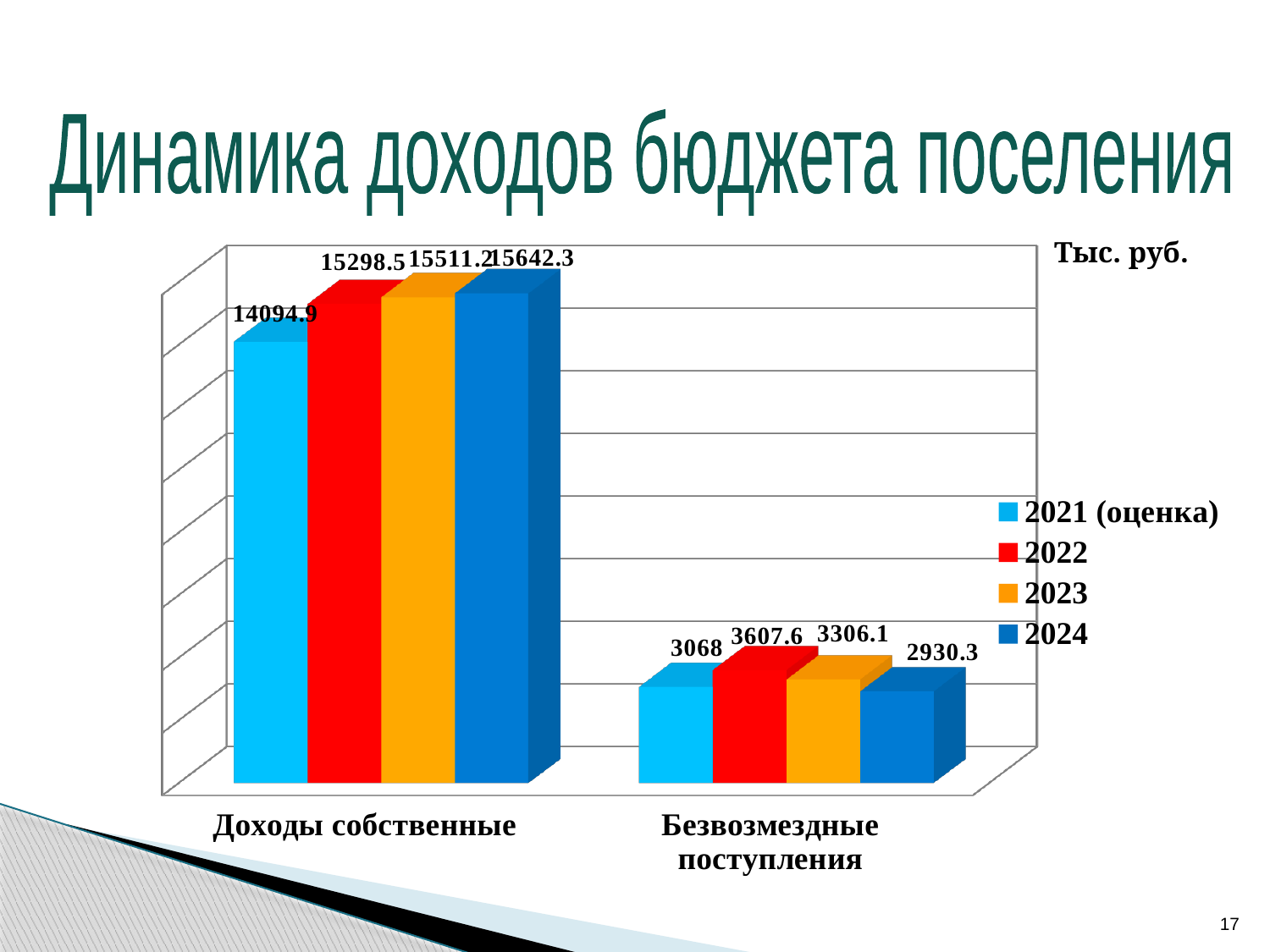
What is the value for 2023 in the "Безвозмездные поступления" category? 3306.1 What is the difference between the 2024 and 2021 (оценка) values in the "Доходы собственные" category? 1547.4 What is the value for 2021 (оценка) in the "Доходы собственные" category? 14094.9 What unit is indicated for the values in the chart? Тыс. руб. What is the value for 2024 in the "Безвозмездные поступления" category? 2930.3 How many series does the legend list? 4 What kind of chart is shown on the slide? Bar chart What is the value for 2022 in the "Доходы собственные" category? 15298.5 Which year has the lowest value in the "Безвозмездные поступления" category? 2024 Which is larger in the "Безвозмездные поступления" category: the value for 2022 or the value for 2023? 2022 Which year has the highest value in the "Доходы собственные" category? 2024 How many categories are shown on the x axis? 2